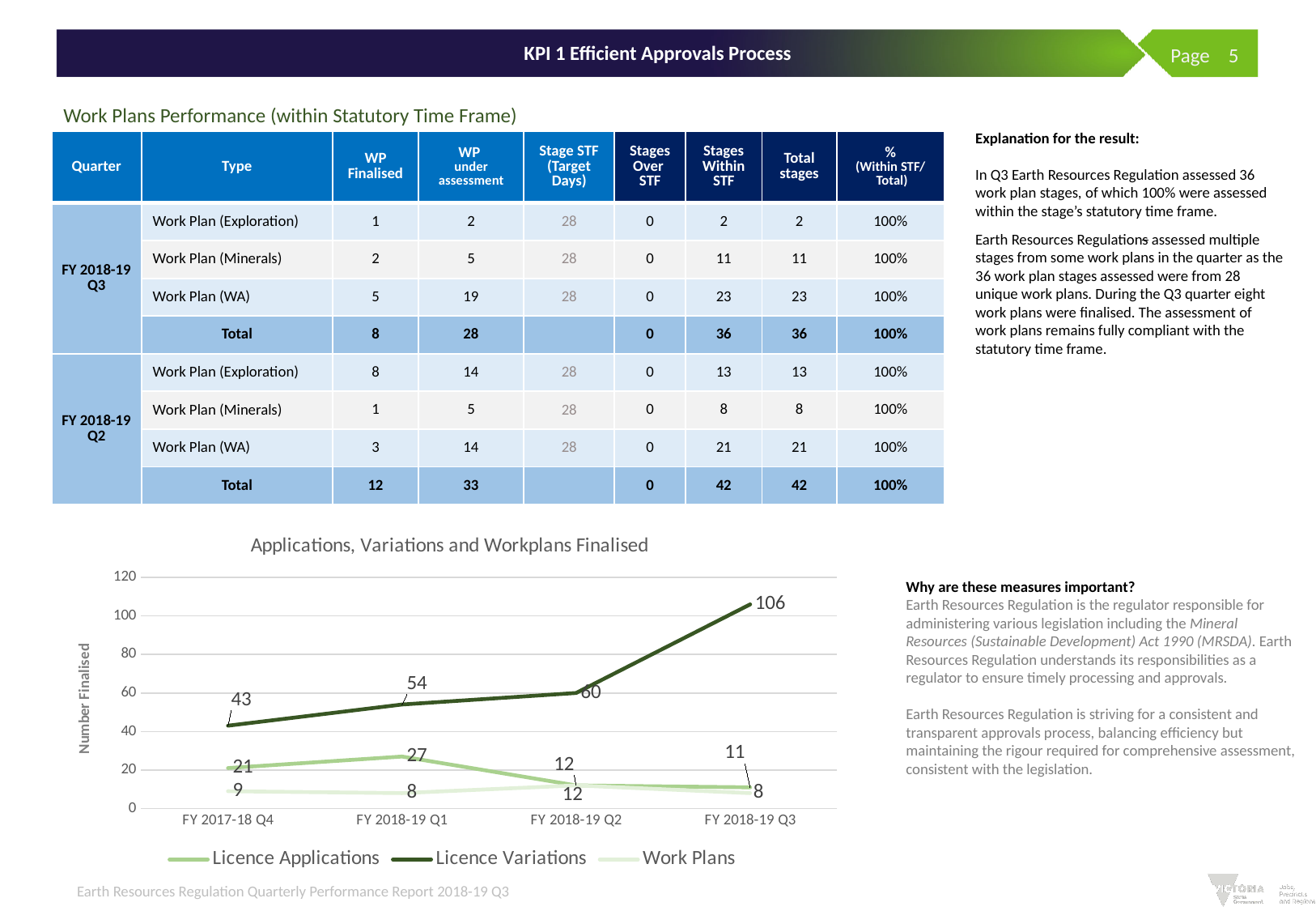
In which quarter is the Licence Variations value highest? FY 2018-19 Q3 What is the value for Work Plans in FY 2017-18 Q4? 9 How many quarters are plotted along the x axis of the 'Applications, Variations and Workplans Finalised' chart? 4 What type of chart is 'Applications, Variations and Workplans Finalised'? line chart Do the Licence Variations values rise or fall across the quarters from FY 2017-18 Q4 to FY 2018-19 Q3? rise What is the value for Licence Variations in FY 2018-19 Q3? 106 What is the value for Licence Applications in FY 2018-19 Q1? 27 How many series does the legend of the 'Applications, Variations and Workplans Finalised' chart list? 3 What is the value for Licence Variations in FY 2017-18 Q4? 43 Which is larger in FY 2017-18 Q4: Licence Applications or Work Plans? Licence Applications What is the difference between Licence Variations in FY 2018-19 Q3 and FY 2018-19 Q2? 46 In which quarter is the Licence Applications value lowest? FY 2018-19 Q3